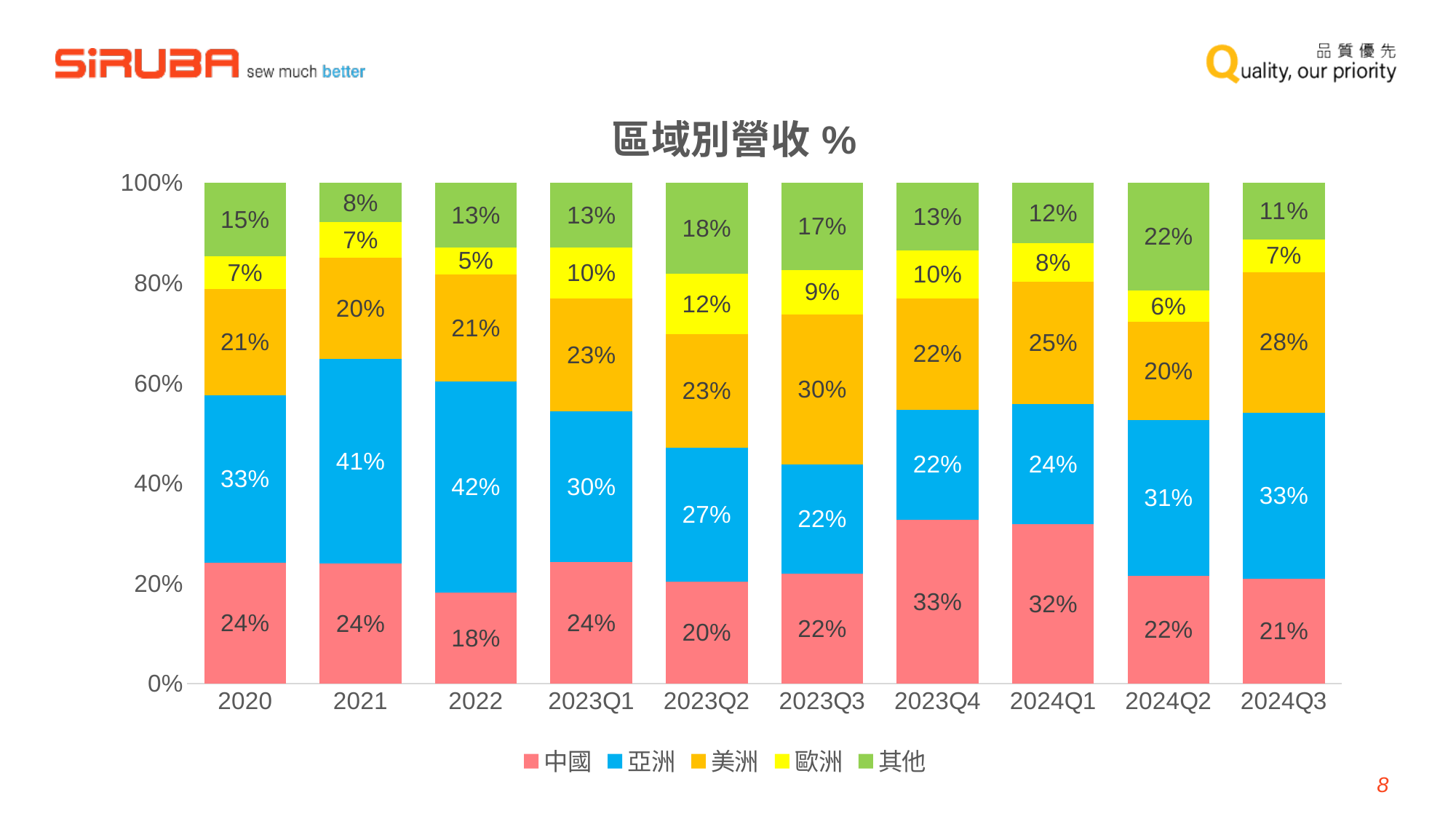
In which period is the 歐洲 share lowest? 2022 In which period is the 中國 share highest? 2023Q4 What is the value for 其他 in 2024Q2? 22% What kind of chart is shown on the slide? Stacked bar chart What is the value for 美洲 in 2024Q3? 28% How many periods are shown on the x axis? 10 What is the value for 亞洲 in 2021? 41% Which is larger in 2023Q3: the 美洲 share or the 亞洲 share? 美洲 What is the value for 中國 in 2022? 18% What is the difference between the 亞洲 share in 2022 and in 2023Q4? 20% What is the title of the chart? 區域別營收 % How many series does the legend list? 5